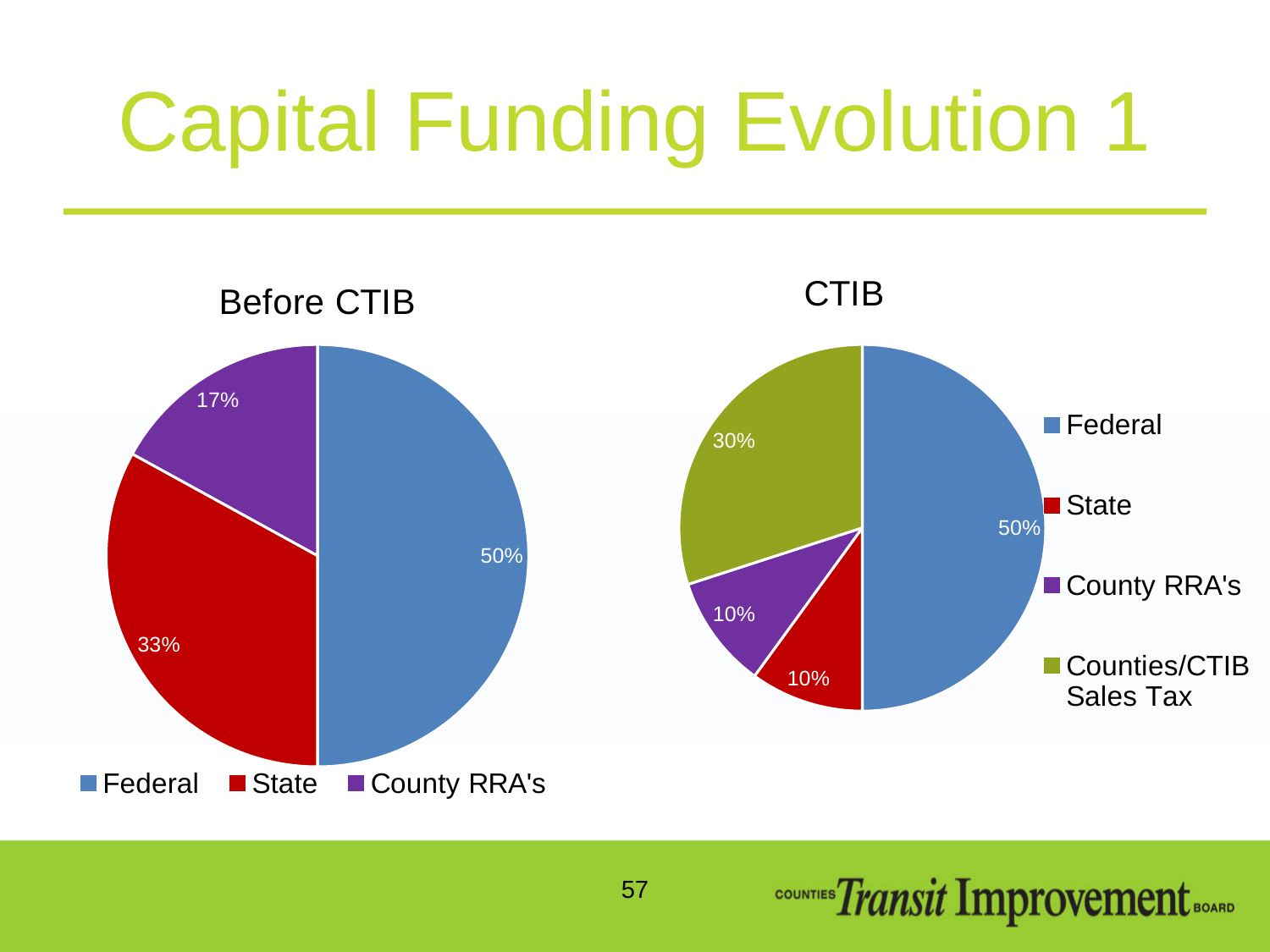
In the "Before CTIB" chart, what is the difference between the State share and the County RRA's share? 16% In the "CTIB" chart, which category has the largest slice? Federal In the "Before CTIB" chart, what share does State have? 33% In the "CTIB" chart, what share does Counties/CTIB Sales Tax have? 30% How many categories does the "CTIB" chart's legend list? 4 In the "Before CTIB" chart, which category has the smallest slice? County RRA's In the "Before CTIB" chart, what share does Federal have? 50% In the "Before CTIB" chart, what share does County RRA's have? 17% In the "CTIB" chart, which is larger, the State slice or the Counties/CTIB Sales Tax slice? Counties/CTIB Sales Tax In the "CTIB" chart, what is the difference between the Federal share and the Counties/CTIB Sales Tax share? 20% What kind of chart is the "Before CTIB" chart? Pie chart In the "CTIB" chart, what share does State have? 10%